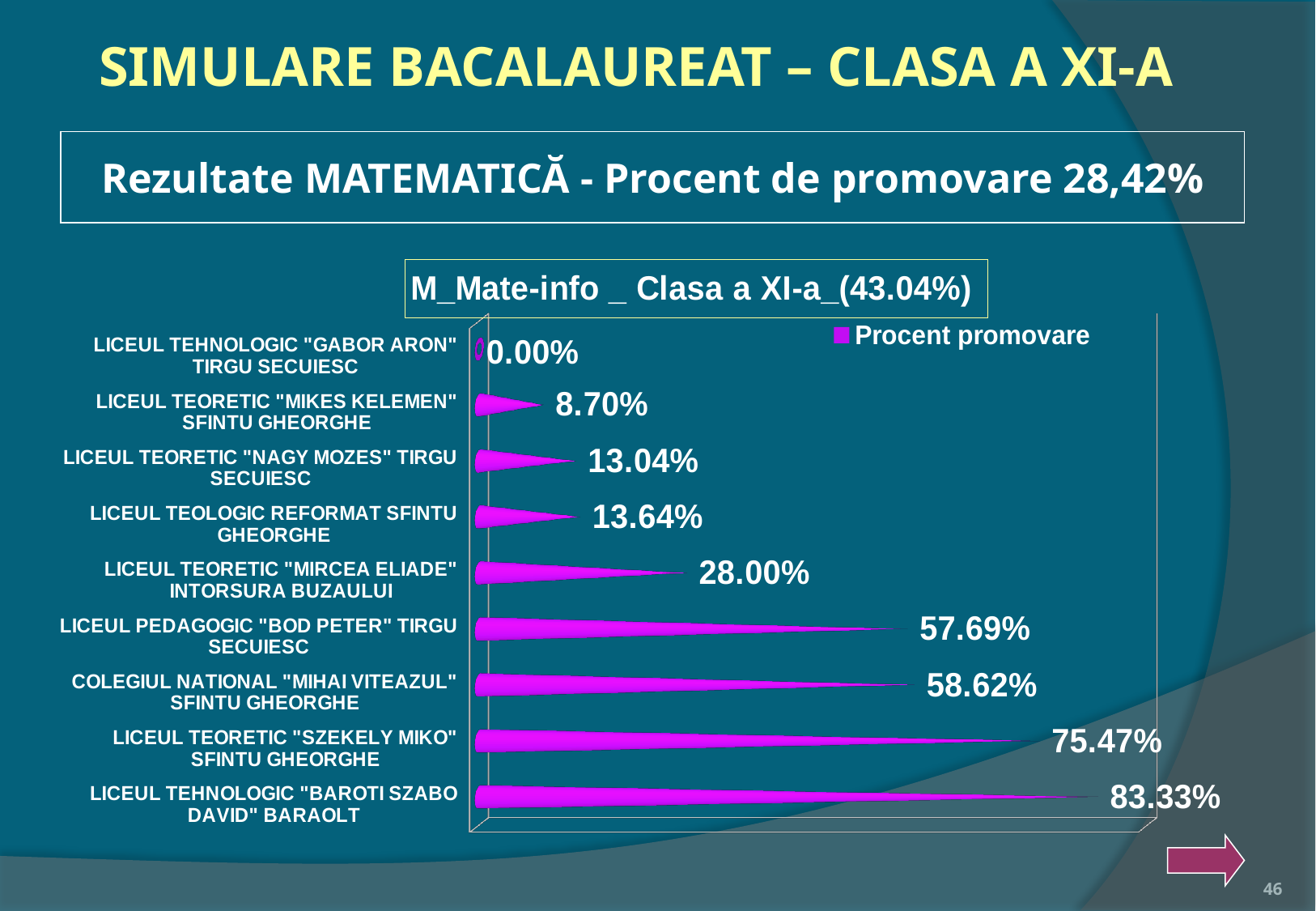
What kind of chart is shown on the slide? Bar chart How many series does the legend list? 1 Which is larger: the value for LICEUL PEDAGOGIC "BOD PETER" TIRGU SECUIESC or for LICEUL TEORETIC "MIRCEA ELIADE" INTORSURA BUZAULUI? LICEUL PEDAGOGIC "BOD PETER" TIRGU SECUIESC Which school has the lowest value in the chart? LICEUL TEHNOLOGIC "GABOR ARON" TIRGU SECUIESC What is the value for LICEUL TEORETIC "SZEKELY MIKO" SFINTU GHEORGHE? 75.47% What is the title of the chart? M_Mate-info _ Clasa a XI-a_(43.04%) What is the name of the series in the legend? Procent promovare Which school has the highest value in the chart? LICEUL TEHNOLOGIC "BAROTI SZABO DAVID" BARAOLT What is the difference between the values for LICEUL TEHNOLOGIC "BAROTI SZABO DAVID" BARAOLT and LICEUL TEORETIC "SZEKELY MIKO" SFINTU GHEORGHE? 7.86% What is the value for LICEUL TEORETIC "MIRCEA ELIADE" INTORSURA BUZAULUI? 28.00% How many schools are shown in the chart? 9 What is the value for LICEUL TEOLOGIC REFORMAT SFINTU GHEORGHE? 13.64%